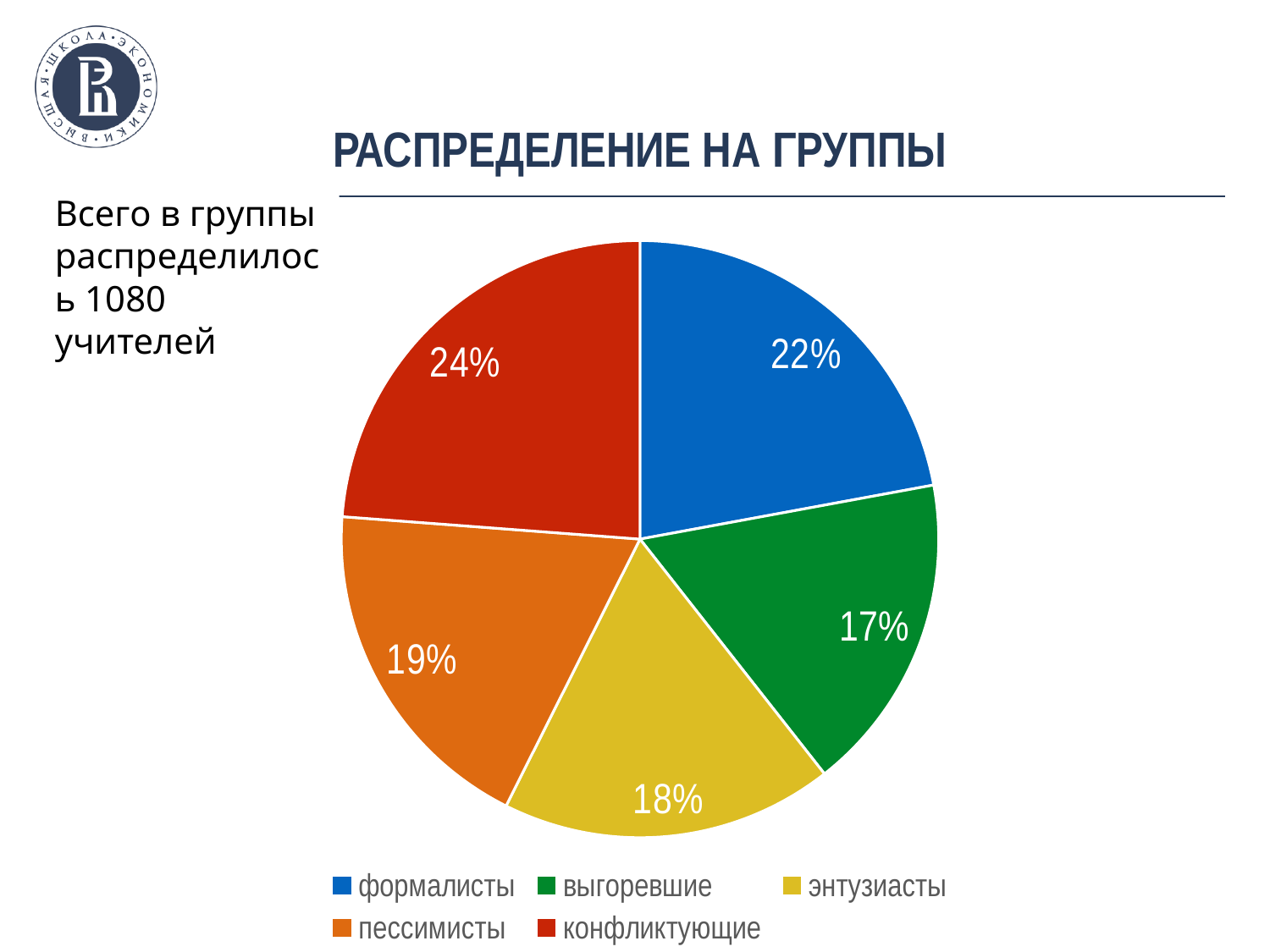
How many groups (slices) are shown in the pie chart? 5 What is the difference in percentage points between конфликтующие and выгоревшие? 7 Which group has the smallest slice of the pie? выгоревшие Which is larger, the share for формалисты or the share for пессимисты? формалисты What is the value shown for пессимисты? 19% What kind of chart is shown on the slide? pie chart What is the value shown for энтузиасты? 18% What is the value shown for выгоревшие? 17% Which group has the largest slice of the pie? конфликтующие What is the title of the chart on the slide? РАСПРЕДЕЛЕНИЕ НА ГРУППЫ What colour is the slice for конфликтующие? red What share of the pie does the формалисты slice represent? 22%